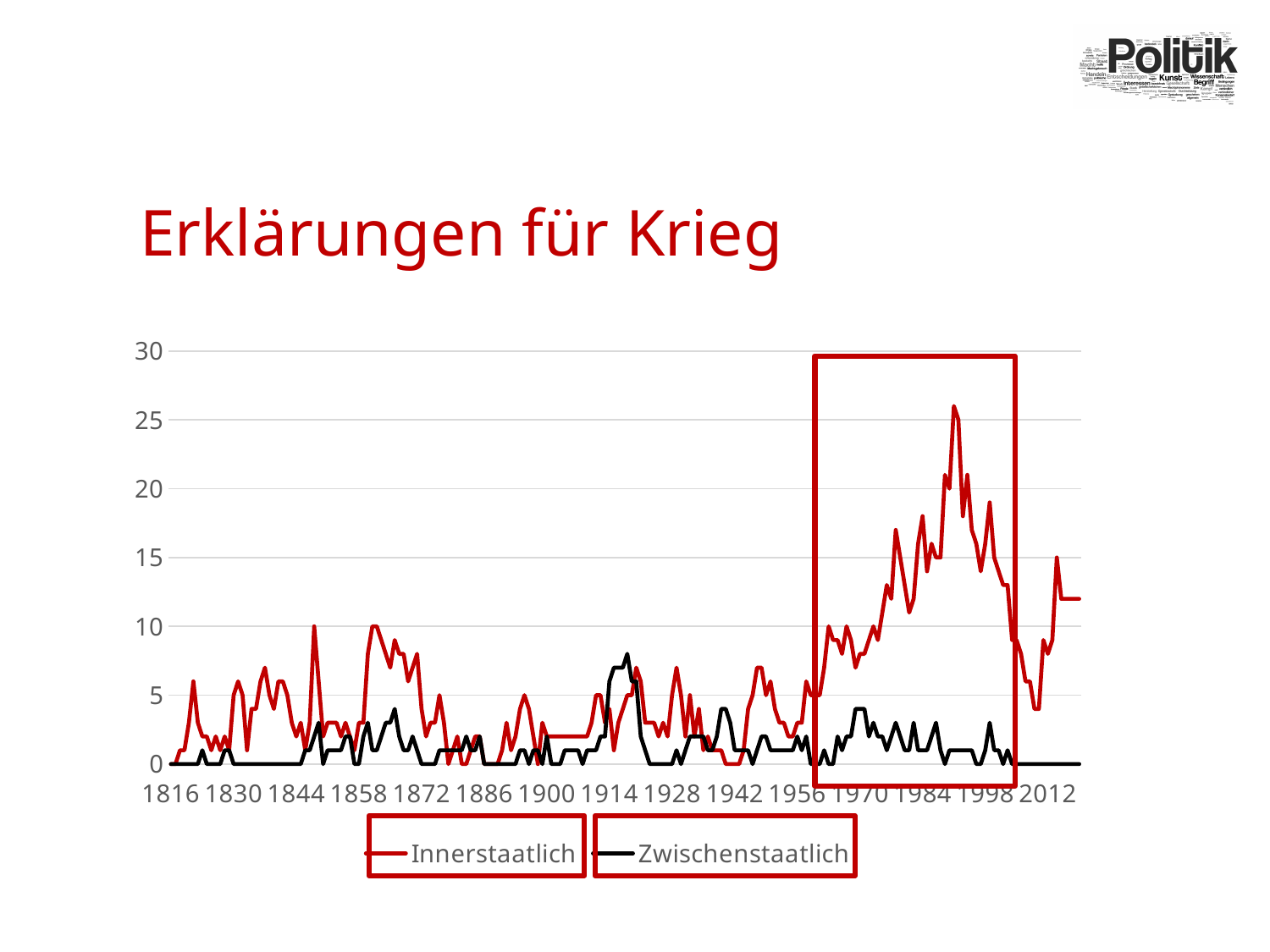
Is the peak value of the Zwischenstaatlich series (around 1914–1928) greater or less than 10? less Which series has the higher value in 1984, Innerstaatlich or Zwischenstaatlich? Innerstaatlich Is the value of the Zwischenstaatlich series at 2012 greater or less than 5? less Which series reaches the higher maximum value, Innerstaatlich or Zwischenstaatlich? Innerstaatlich What kind of chart is shown on the slide? line chart How many year labels are shown on the x axis? 15 Does the Innerstaatlich series generally rise or fall between 1956 and 1990? rise How many series does the legend list? 2 Is the value of the Innerstaatlich series at 2012 greater or less than 10? less Which series is drawn in black according to the legend? Zwischenstaatlich What is the title of the slide containing the chart? Erklärungen für Krieg